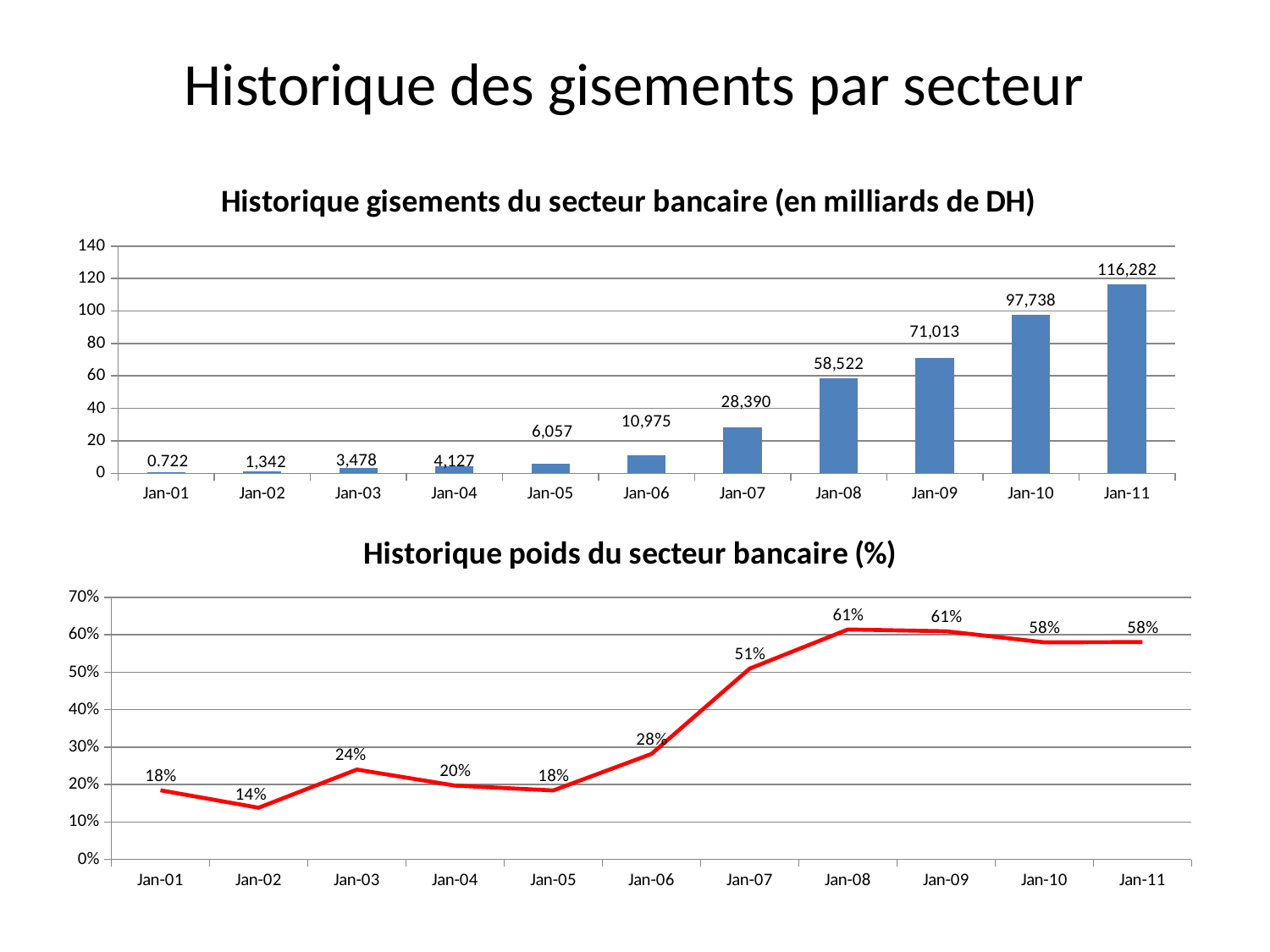
In the chart 'Historique gisements du secteur bancaire (en milliards de DH)', which period has the lowest value? Jan-01 In the chart 'Historique poids du secteur bancaire (%)', which is larger, the value for Jan-03 or the value for Jan-06? Jan-06 In the chart 'Historique gisements du secteur bancaire (en milliards de DH)', what is the value for Jan-07? 28,390 In the chart 'Historique gisements du secteur bancaire (en milliards de DH)', do the values generally rise or fall from Jan-01 to Jan-11? rise In the chart 'Historique gisements du secteur bancaire (en milliards de DH)', how many periods are shown on the x axis? 11 What kind of chart is 'Historique poids du secteur bancaire (%)'? line chart In the chart 'Historique gisements du secteur bancaire (en milliards de DH)', what is the value for Jan-11? 116,282 In the chart 'Historique poids du secteur bancaire (%)', what is the difference between the values for Jan-08 and Jan-07? 10% In the chart 'Historique poids du secteur bancaire (%)', what is the value for Jan-08? 61% In the chart 'Historique gisements du secteur bancaire (en milliards de DH)', which period has the highest value? Jan-11 What kind of chart is 'Historique gisements du secteur bancaire (en milliards de DH)'? bar chart In the chart 'Historique poids du secteur bancaire (%)', what is the value for Jan-02? 14%